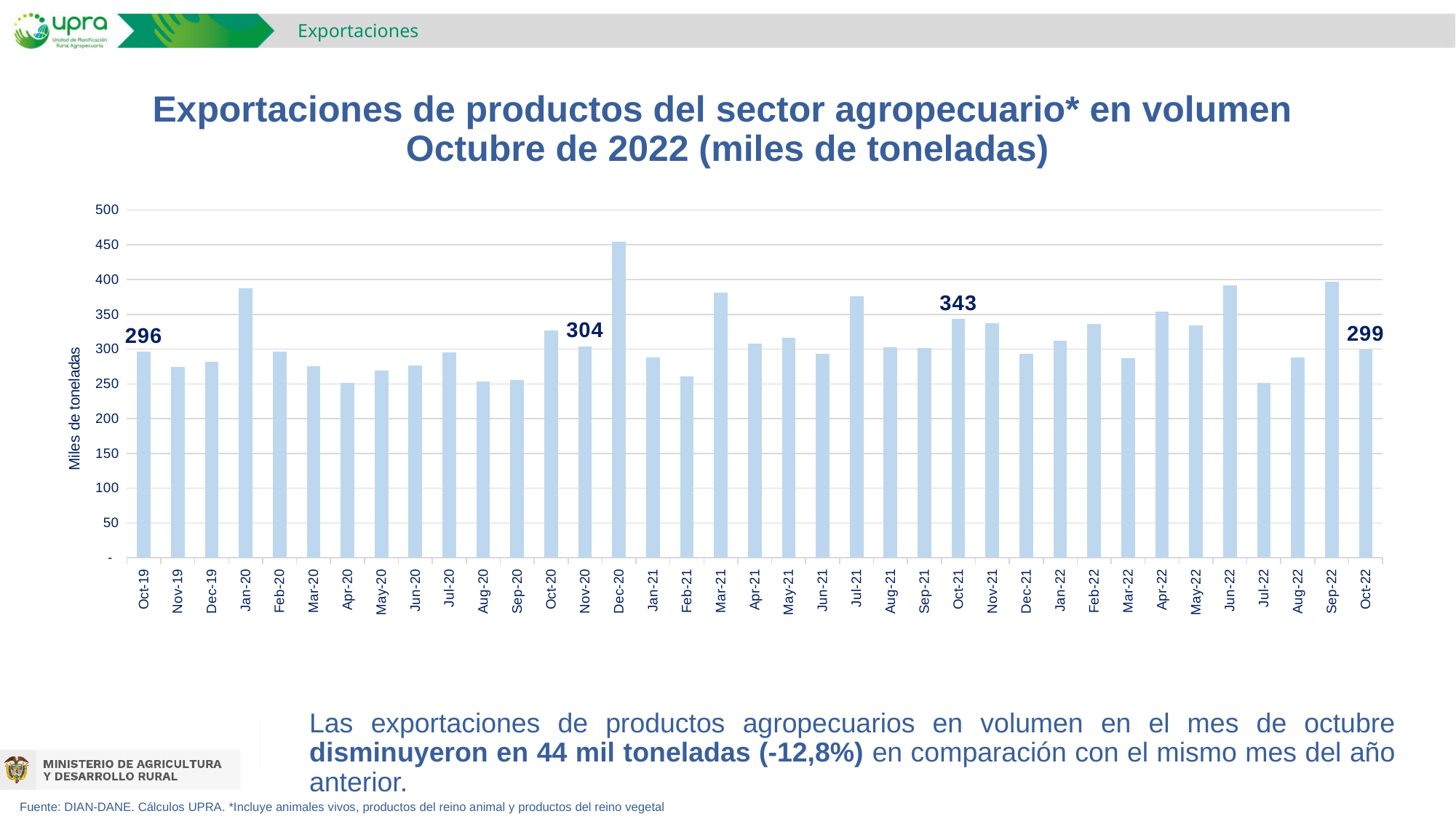
What is the difference between the values for Oct-21 and Oct-22? 44 Is the value for Dec-20 greater or less than 400? greater What is the value for Nov-20? 304 How many months are plotted on the chart? 37 What type of chart is shown on the slide? bar chart What is the value for Oct-22? 299 Which month has the highest value? Dec-20 What is the label of the vertical axis? Miles de toneladas Which is larger, the value for Oct-21 or the value for Oct-19? Oct-21 What is the value for Oct-21? 343 What is the value for Oct-19? 296 Is the value for Apr-20 greater or less than 300? less